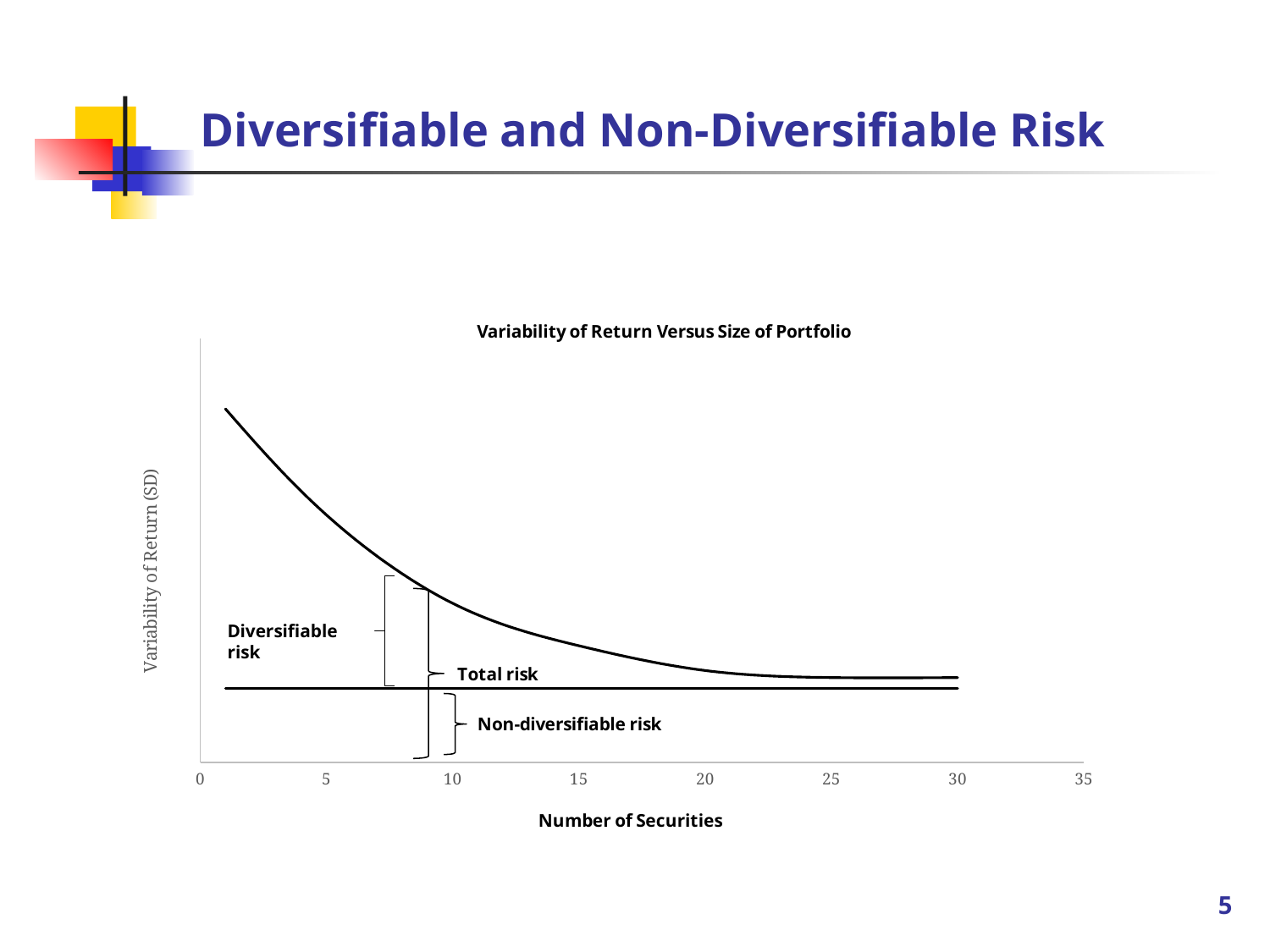
What label is given to the gap between the curve and the horizontal line? Diversifiable risk Does the curved line rise or fall as the number of securities increases? Fall What kind of chart is shown on the slide? Line chart Does the curve flatten out or keep falling steeply between 25 and 30 securities? Flattens out What is the title of the chart? Variability of Return Versus Size of Portfolio How many tick labels are shown on the x axis? 8 What is the label of the y axis? Variability of Return (SD) Is the curve higher at 5 securities or at 20 securities? 5 securities